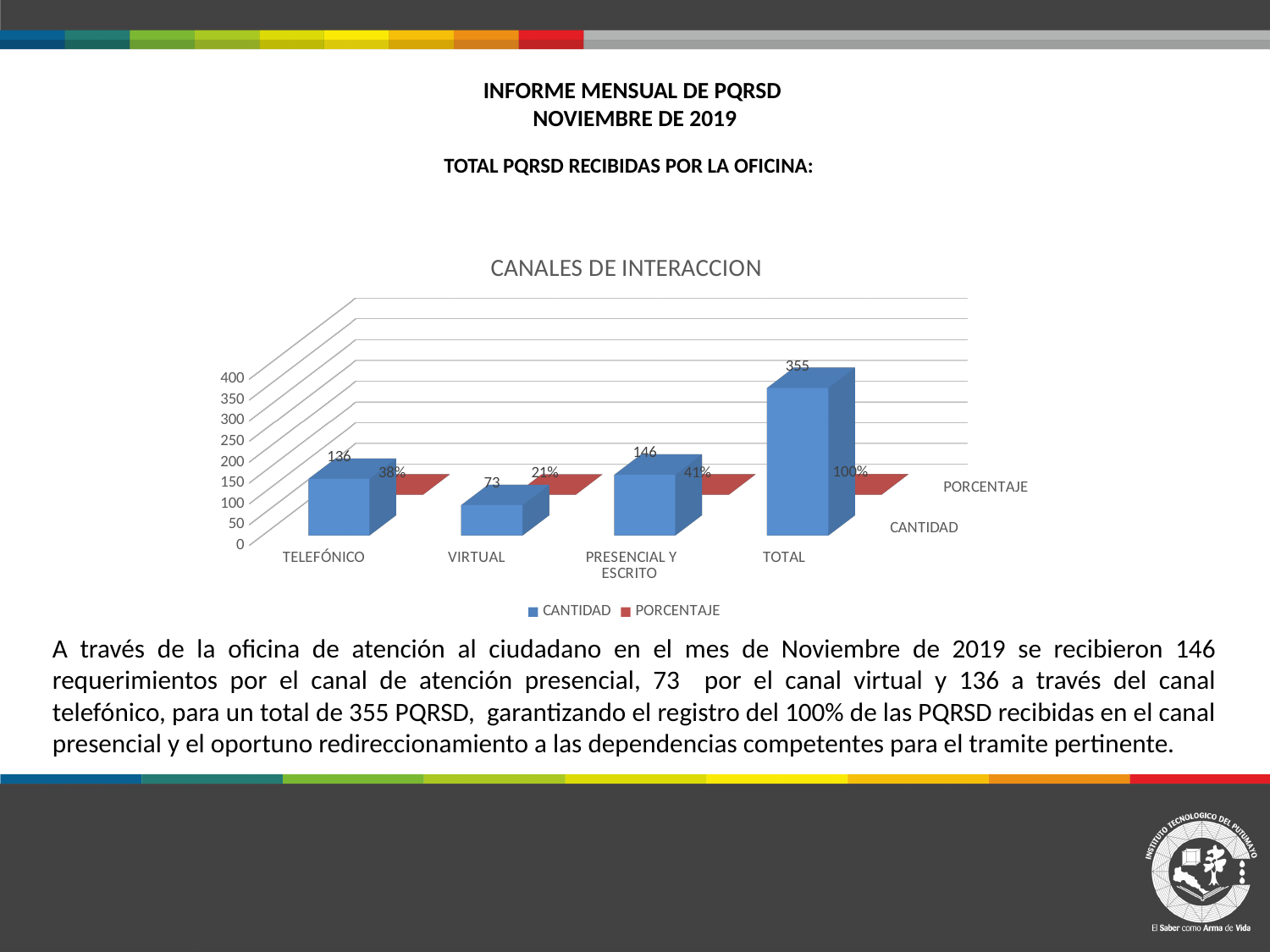
What is the difference between the CANTIDAD values for PRESENCIAL Y ESCRITO and VIRTUAL? 73 What is the CANTIDAD value for TELEFÓNICO? 136 How many categories are shown on the x axis of the chart? 4 What is the PORCENTAJE value for VIRTUAL? 21% Which category has the highest CANTIDAD value? TOTAL Which category has the lowest CANTIDAD value? VIRTUAL What is the CANTIDAD value for VIRTUAL? 73 What is the PORCENTAJE value for PRESENCIAL Y ESCRITO? 41% What is the title of the chart? CANALES DE INTERACCION How many series does the legend list? 2 What is the CANTIDAD value for PRESENCIAL Y ESCRITO? 146 Which has a larger CANTIDAD value, TELEFÓNICO or PRESENCIAL Y ESCRITO? PRESENCIAL Y ESCRITO